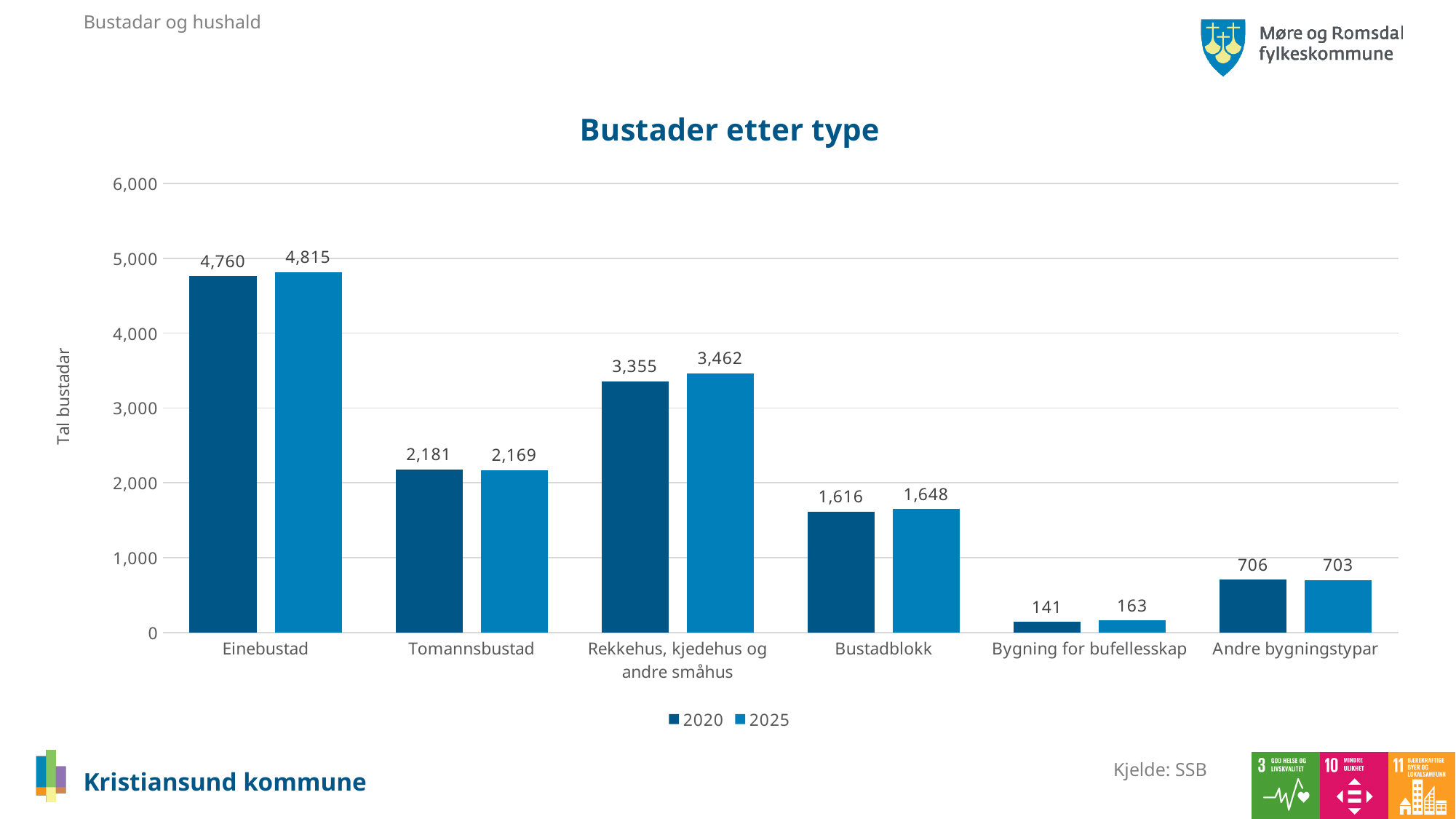
Which is larger for Tomannsbustad: the 2020 value or the 2025 value? 2020 Is the 2020 value for Andre bygningstypar greater or less than 1,000? less What kind of chart is shown? bar chart How many series does the legend list? 2 What is the value for Einebustad in 2025? 4,815 Which category has the highest value in 2020? Einebustad Which category has the lowest value in 2025? Bygning for bufellesskap What is the title of the chart? Bustader etter type What is the value for Bygning for bufellesskap in 2025? 163 What is the difference between the 2025 and 2020 values for Rekkehus, kjedehus og andre småhus? 107 How many categories are shown on the x axis? 6 What is the value for Bustadblokk in 2020? 1,616